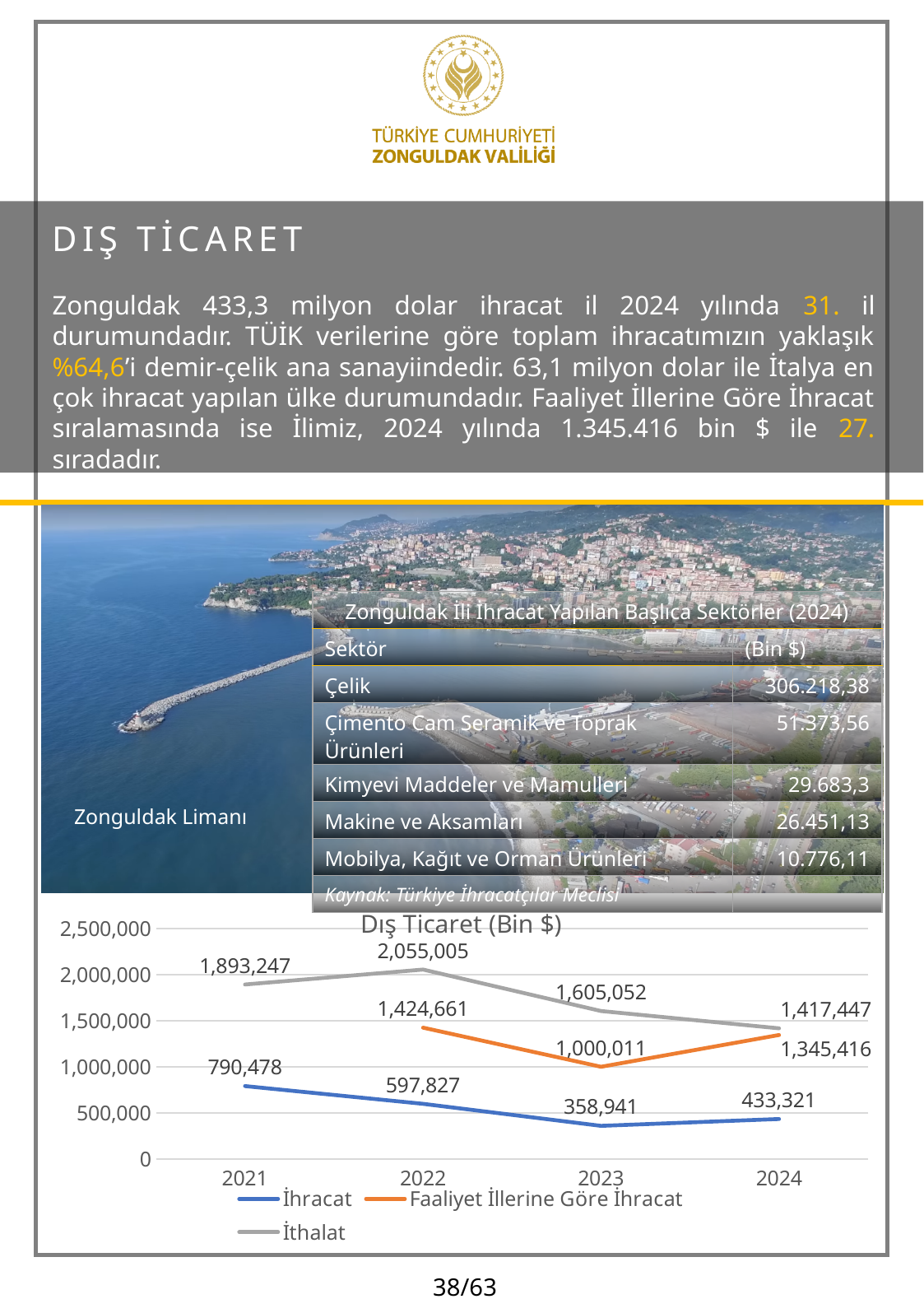
In the "Dış Ticaret (Bin $)" chart, which year has the highest İthalat value? 2022 In the "Dış Ticaret (Bin $)" chart, what is the difference between the İthalat values for 2021 and 2024? 475,800 In the "Dış Ticaret (Bin $)" chart, which year has the lowest İhracat value? 2023 How many series does the legend of the "Dış Ticaret (Bin $)" chart list? 3 What type of chart is "Dış Ticaret (Bin $)"? line chart In the "Dış Ticaret (Bin $)" chart, what is the İhracat value for 2021? 790,478 In the "Dış Ticaret (Bin $)" chart, what is the İhracat value for 2024? 433,321 In the "Dış Ticaret (Bin $)" chart, what is the İthalat value for 2022? 2,055,005 In the "Dış Ticaret (Bin $)" chart, how many years are shown on the x axis? 4 In the "Dış Ticaret (Bin $)" chart, what is the Faaliyet İllerine Göre İhracat value for 2023? 1,000,011 In the "Dış Ticaret (Bin $)" chart, does the İhracat series rise or fall from 2021 to 2023? fall In the "Dış Ticaret (Bin $)" chart, which is larger in 2024: İthalat or Faaliyet İllerine Göre İhracat? İthalat